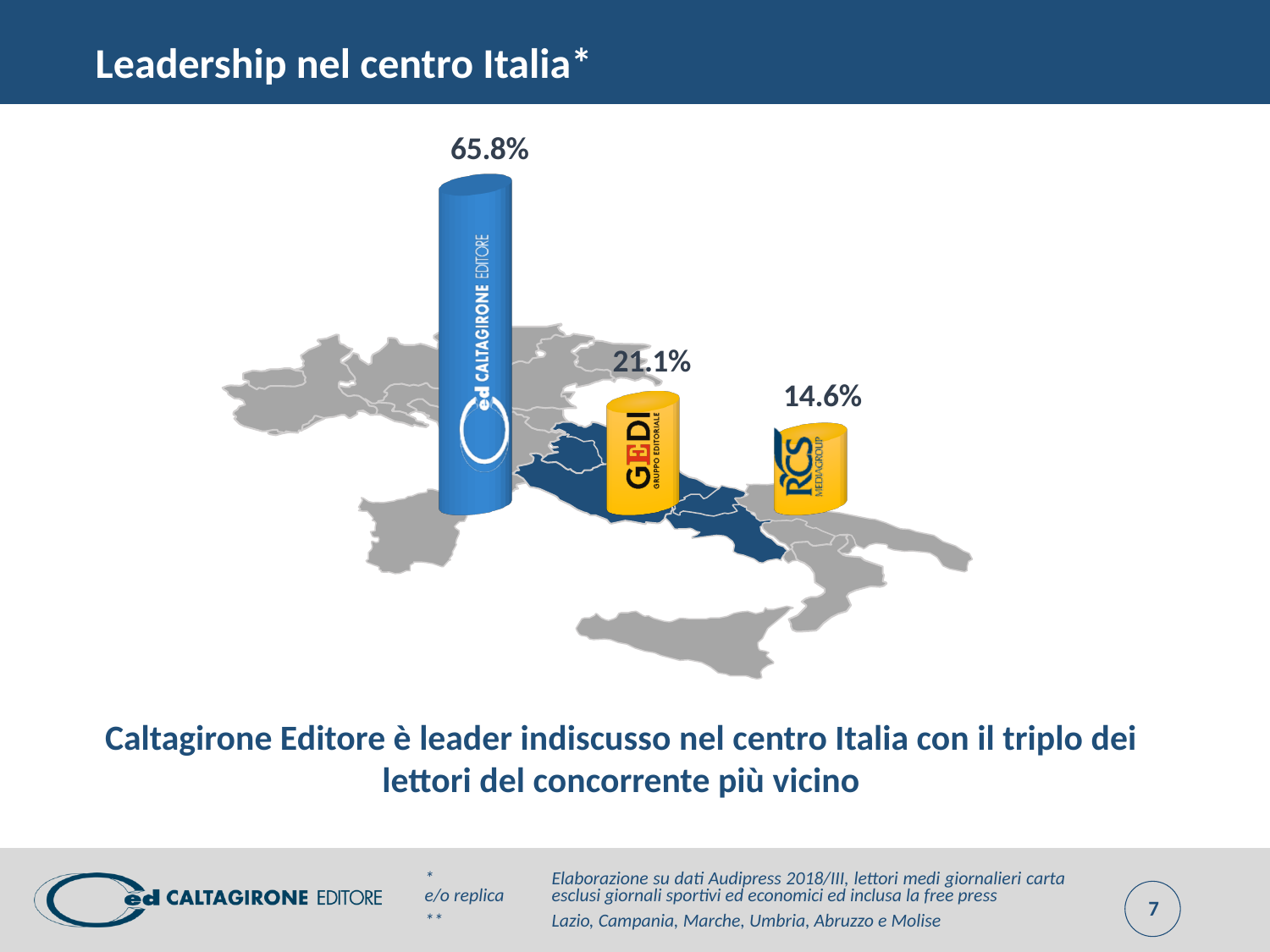
What is the difference between the values for Caltagirone Editore and GEDI? 44.7 percentage points What is the value shown for RCS? 14.6% Which is larger, the value for GEDI or the value for RCS? GEDI What colour is the bar for Caltagirone Editore? Blue What kind of chart is shown on the slide? Bar chart Which publisher has the highest value on the chart? Caltagirone Editore What is the title of the slide containing the chart? Leadership nel centro Italia* How many publishers are shown as bars on the chart? 3 What is the difference between the values for GEDI and RCS? 6.5 percentage points Which publisher has the lowest value on the chart? RCS What is the value shown for Caltagirone Editore? 65.8% What is the value shown for GEDI? 21.1%